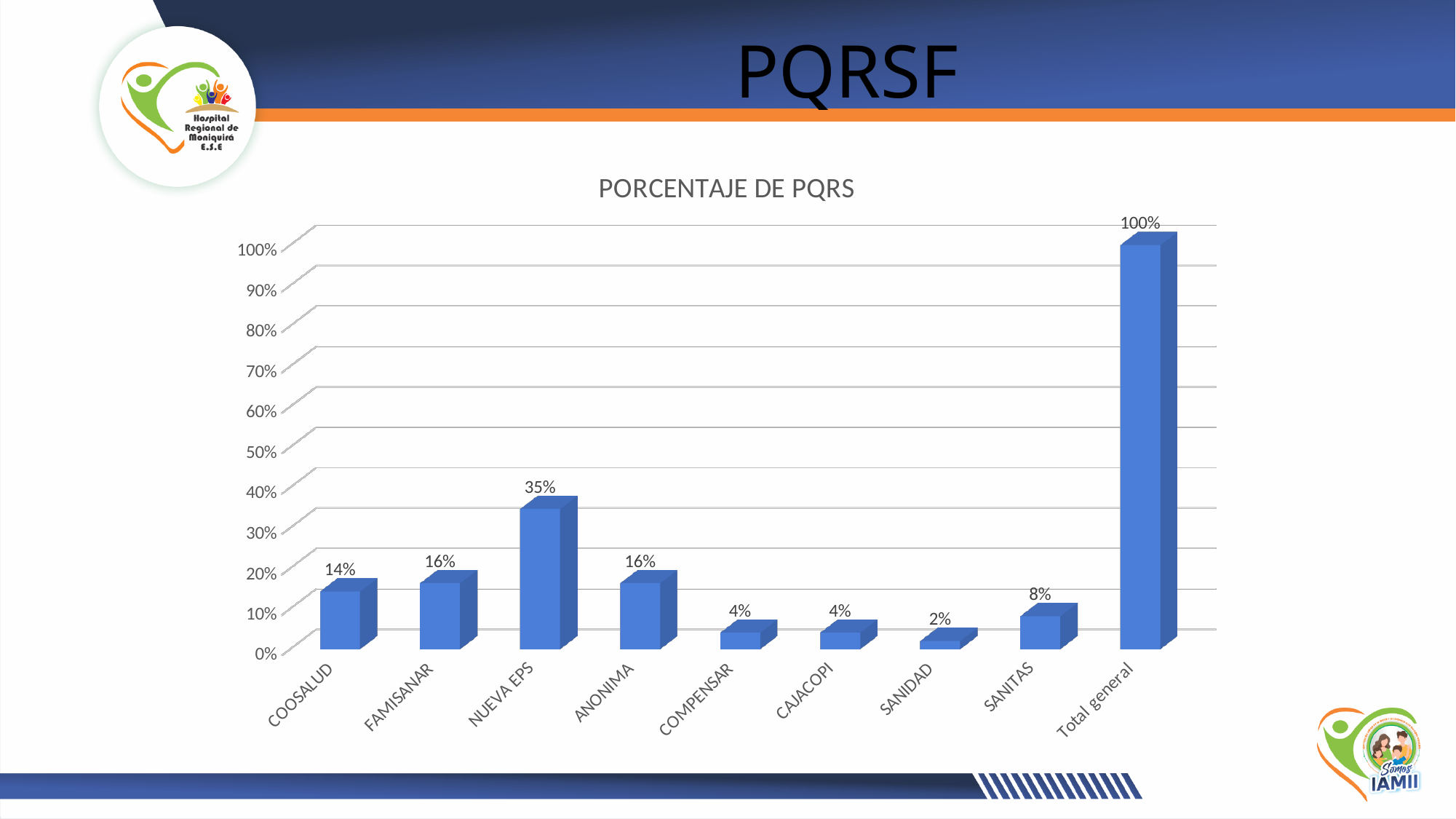
What is the value for NUEVA EPS? 35% How many bars are shown in the chart, including Total general? 9 What is the title of the chart? PORCENTAJE DE PQRS What kind of chart is shown on the slide? Bar chart What is the value for COOSALUD? 14% Which is larger, the value for SANITAS or the value for COMPENSAR? SANITAS What is the value for SANIDAD? 2% Excluding the Total general bar, which category has the highest value? NUEVA EPS What is the difference between the values for NUEVA EPS and FAMISANAR? 19% What is the value for SANITAS? 8% Is the value for ANONIMA greater or less than 10%? greater Which category has the lowest value? SANIDAD